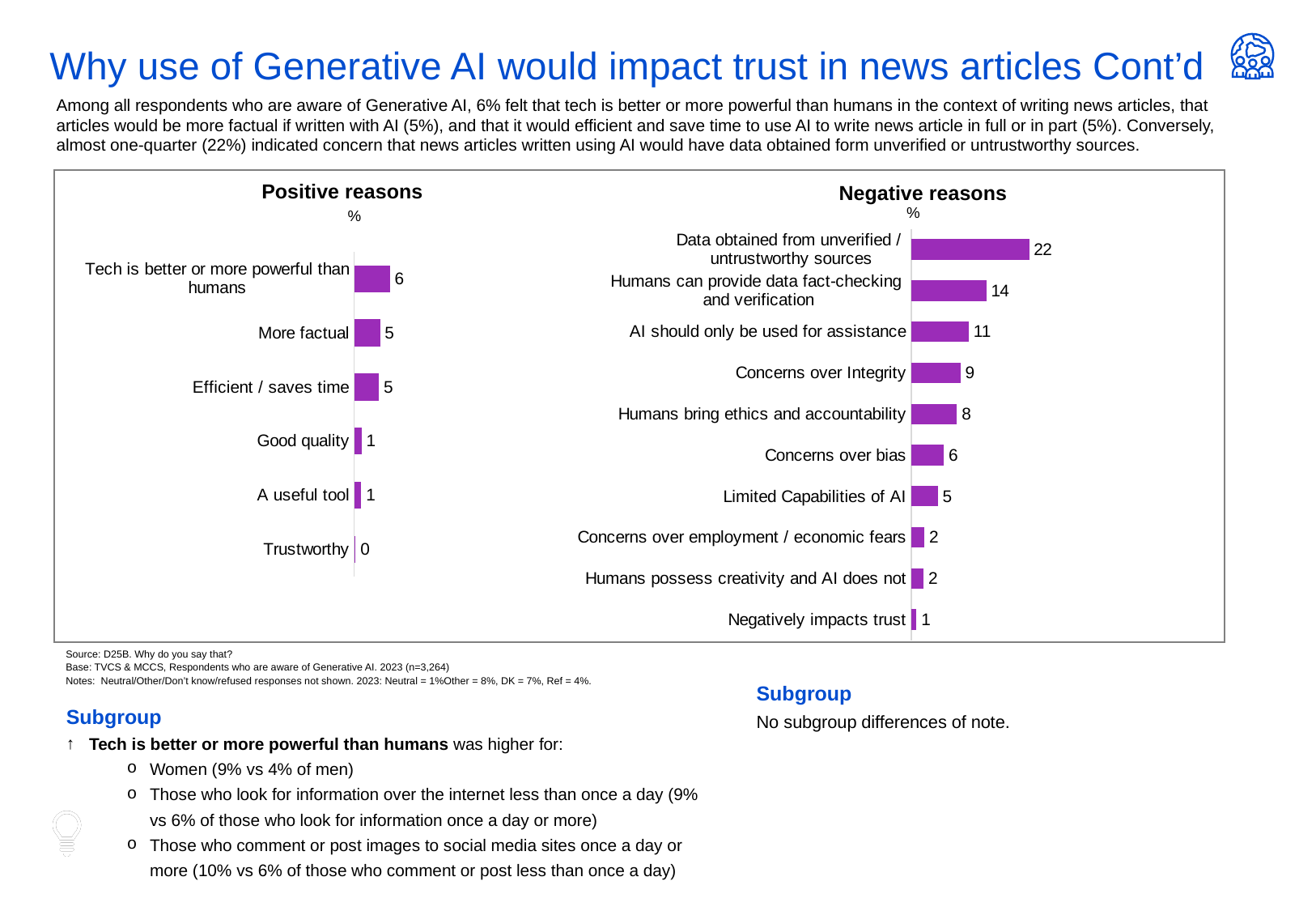
How many categories are shown in the Positive reasons chart? 6 In the Negative reasons chart, which category has the highest value? Data obtained from unverified / untrustworthy sources In the Positive reasons chart, what is the value for "Good quality"? 1 What type of chart is the Negative reasons chart? Bar chart In the Positive reasons chart, what is the value for "Tech is better or more powerful than humans"? 6 In the Negative reasons chart, what is the value for "Humans can provide data fact-checking and verification"? 14 In the Negative reasons chart, what is the difference between "Data obtained from unverified / untrustworthy sources" and "AI should only be used for assistance"? 11 How many categories are shown in the Negative reasons chart? 10 In the Negative reasons chart, what is the value for "Negatively impacts trust"? 1 In the Negative reasons chart, which is larger: "Concerns over Integrity" or "Concerns over bias"? Concerns over Integrity In the Positive reasons chart, which category has the lowest value? Trustworthy What is the title of the chart on the left side of the slide? Positive reasons